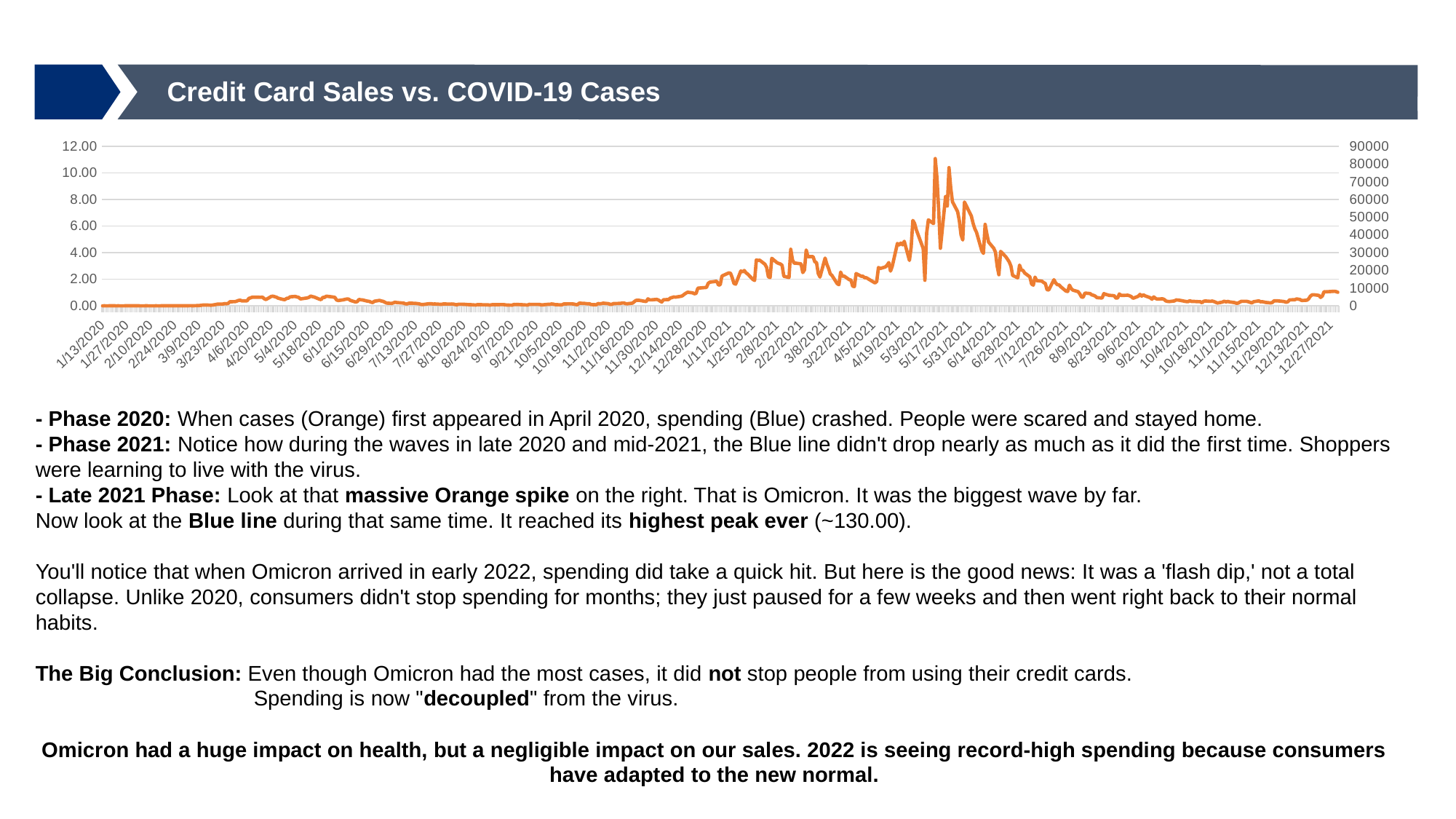
What is the title of the chart on the slide? Credit Card Sales vs. COVID-19 Cases Is the value of the orange line around 8/23/2021 greater or less than 10000 on the right-hand axis? less Is the value of the orange line around 2/8/2021 greater or less than 10000 on the right-hand axis? greater Does the orange line rise or fall between 4/19/2021 and 5/17/2021? rise Is the value of the orange line at 1/13/2020 greater or less than 10000 on the right-hand axis? less In which month does the orange line reach its highest peak? May 2021 Does the orange line rise or fall between 5/31/2021 and 8/9/2021? fall Which is larger on the orange line: the value around 5/17/2021 or the value around 1/13/2020? 5/17/2021 Which is larger on the orange line: the value around 12/27/2021 or the value around 5/3/2021? 5/3/2021 What colour is the line plotted on the chart? orange What kind of chart is shown on the slide? line chart